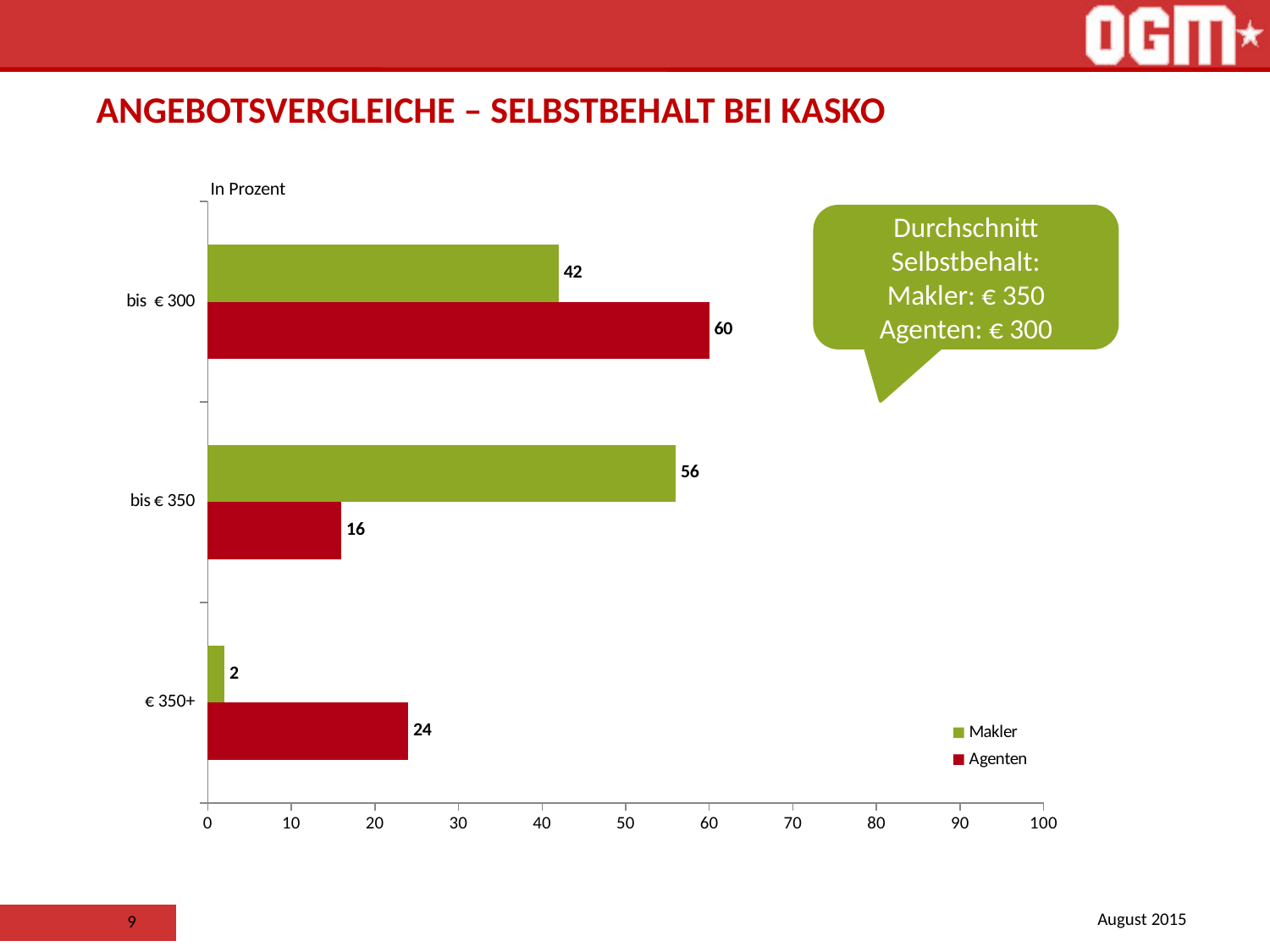
What is the difference between the Agenten and Makler values in the 'bis € 300' category? 18 How many categories are shown on the chart? 3 Which is larger in the 'bis € 350' category, Makler or Agenten? Makler What is the value for Agenten in the 'bis € 350' category? 16 How many series does the legend list? 2 Is the value for Makler in the 'bis € 350' category greater or less than 50? greater What is the value for Agenten in the '€ 350+' category? 24 Which colour represents the Agenten series? red Which category has the lowest value for Makler? € 350+ Which category has the highest value for Agenten? bis € 300 What kind of chart is shown on the slide? bar chart What is the value for Makler in the 'bis € 300' category? 42